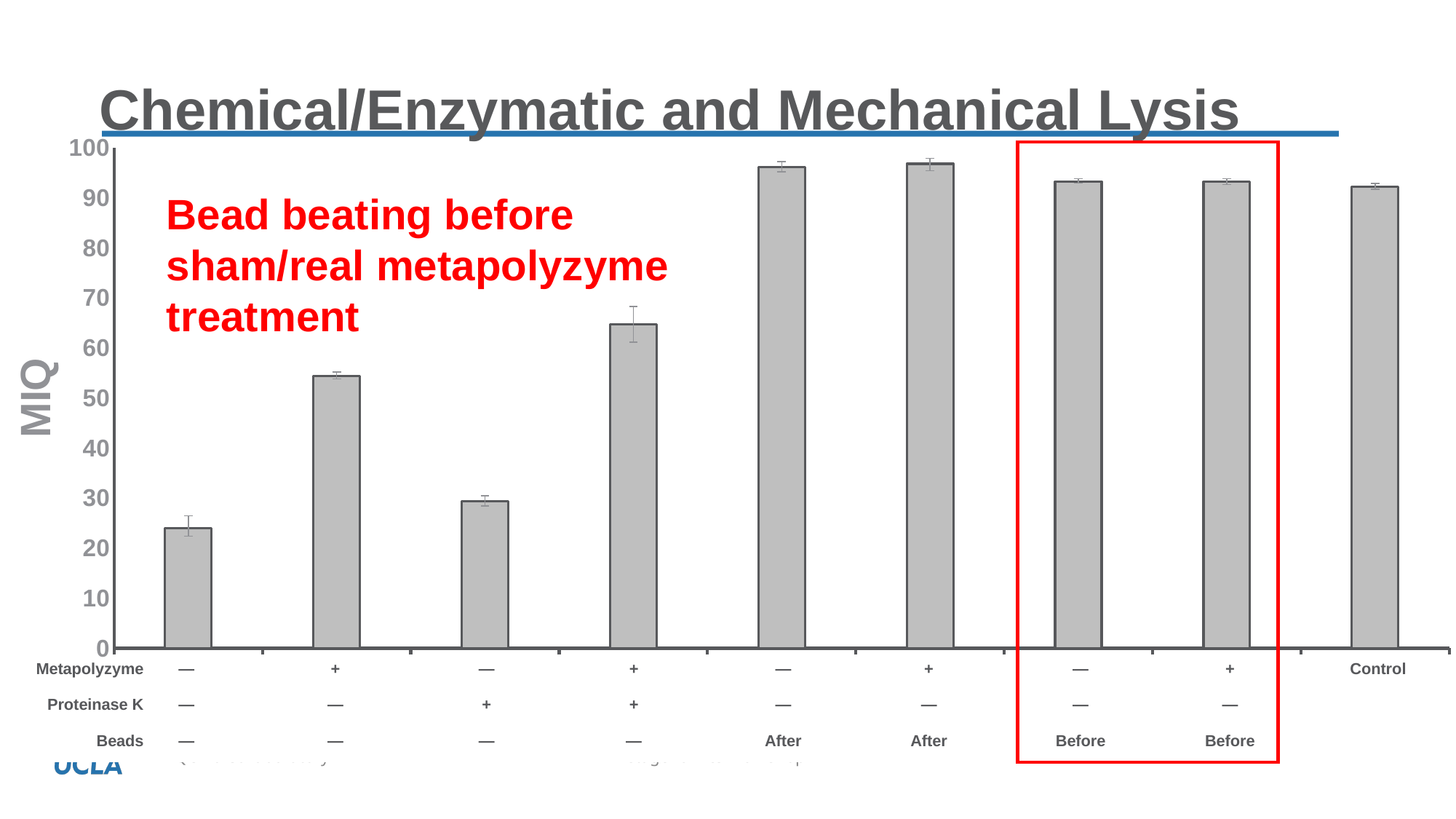
Is the value for the bar with Metapolyzyme +, Proteinase K −, Beads − greater or less than 50? greater Which is larger: the bar with Metapolyzyme +, Proteinase K −, Beads − or the bar with Metapolyzyme −, Proteinase K +, Beads −? Metapolyzyme +, Proteinase K −, Beads − Which bar has the lowest MIQ value? Metapolyzyme −, Proteinase K −, Beads − What is the label of the y axis? MIQ Is the value for the bar with Metapolyzyme −, Proteinase K −, Beads − greater or less than 30? less Is the value for the Control bar greater or less than 90? greater What kind of chart is shown on the slide? bar chart What is the title of the slide containing the chart? Chemical/Enzymatic and Mechanical Lysis Which is larger: the Control bar or the bar with Metapolyzyme +, Proteinase K +, Beads −? Control How many bars are plotted in the chart? 9